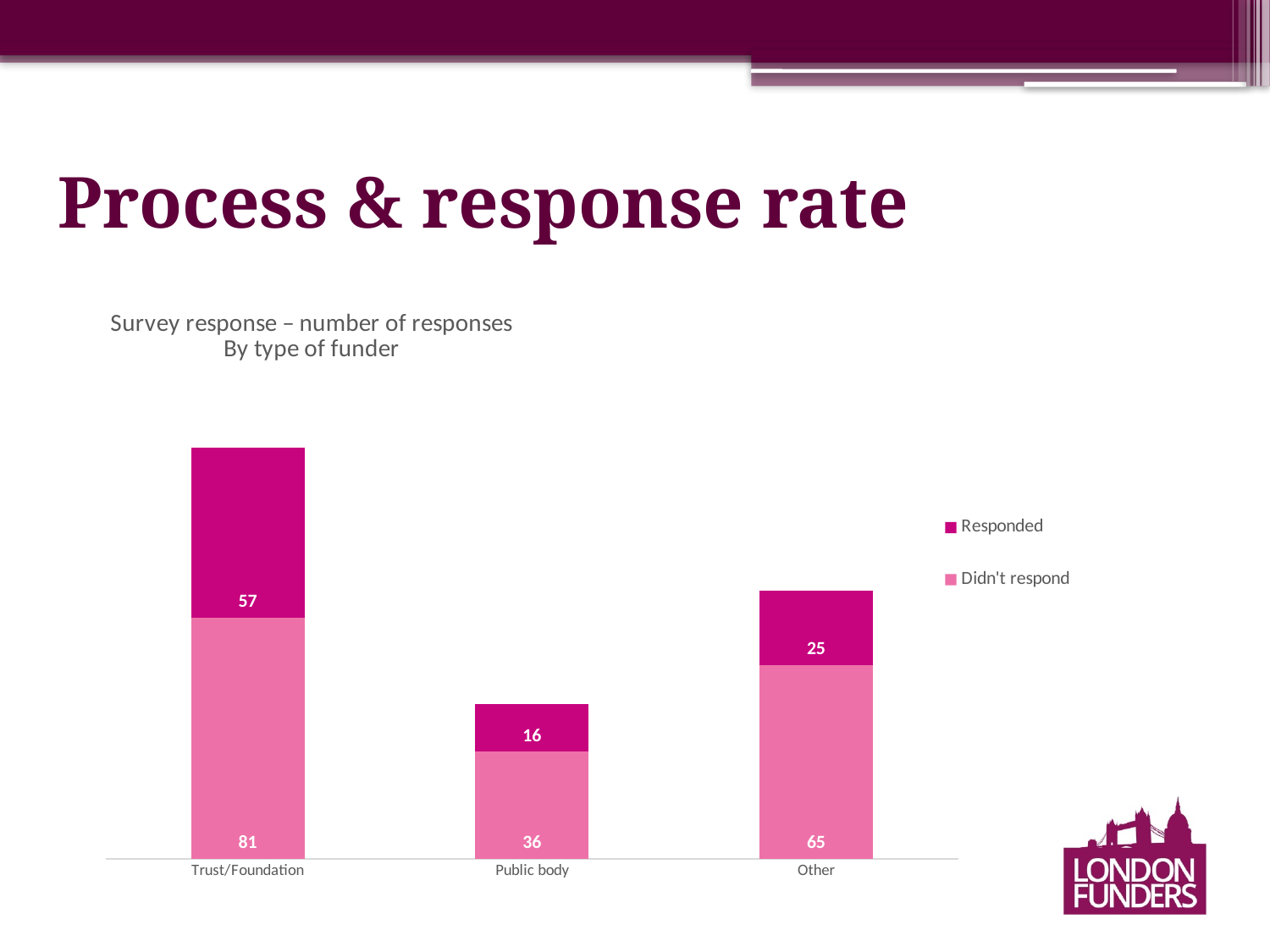
What is the value for Responded in the Trust/Foundation category? 57 How many series does the legend list? 2 Which category has the lowest Responded value? Public body What is the title of the chart? Survey response – number of responses By type of funder Which is larger: the Responded value for Public body or the Responded value for Other? Other What is the value for Didn't respond in the Public body category? 36 What is the difference between the Didn't respond values for Trust/Foundation and Other? 16 What is the total of the stacked bar for Trust/Foundation? 138 How many categories are shown on the x axis? 3 Which category has the highest Didn't respond value? Trust/Foundation What kind of chart is shown on the slide? Stacked bar chart What is the value for Responded in the Other category? 25